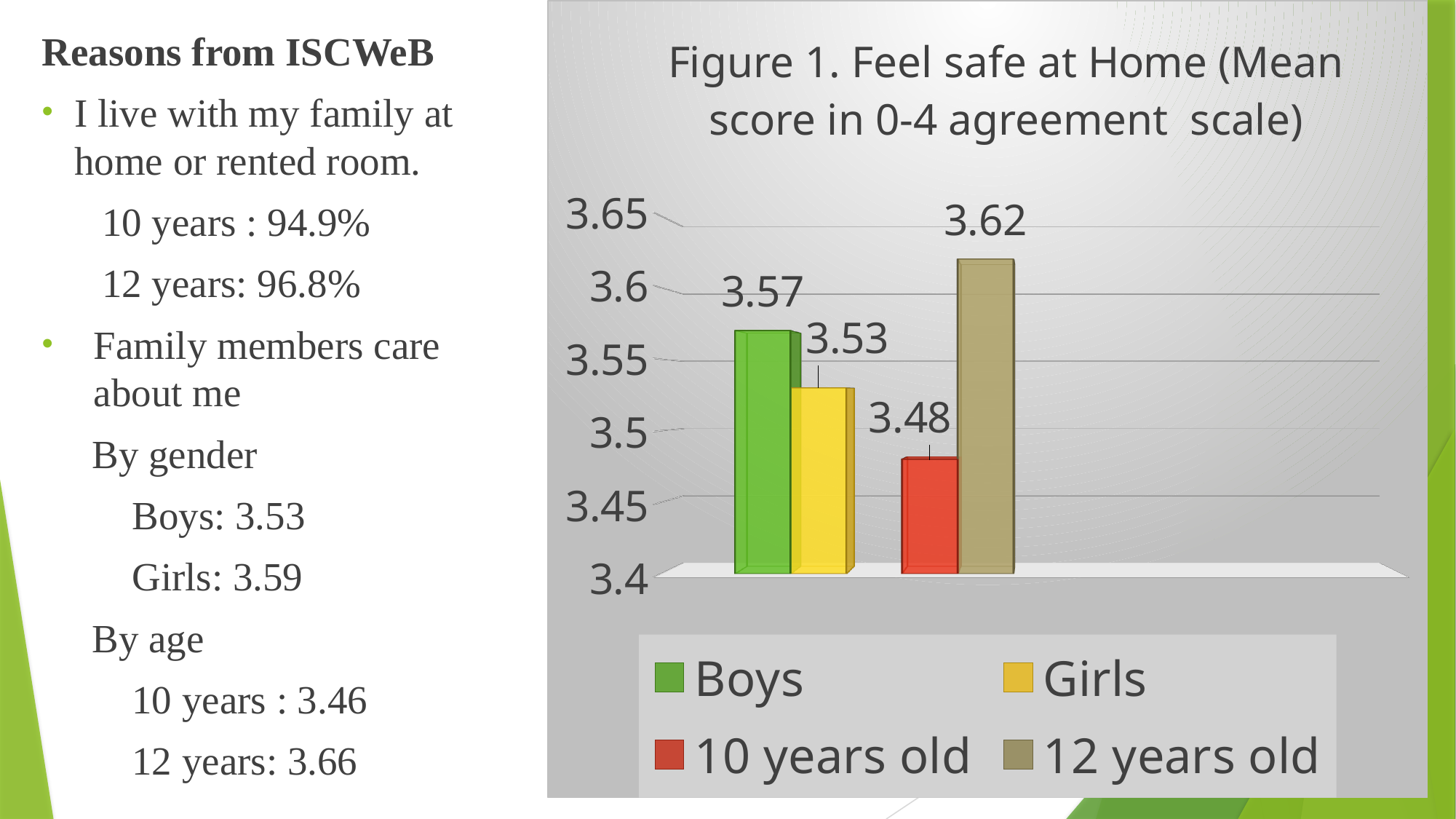
What kind of chart is shown on the slide? bar chart Which group has the highest value in the chart? 12 years old What is the value for 10 years old in the chart? 3.48 How many series does the legend list? 4 Which group has the lowest value in the chart? 10 years old Which is larger, the value for Boys or the value for Girls? Boys What is the title of the chart? Figure 1. Feel safe at Home (Mean score in 0-4 agreement scale) What is the value for Girls in the chart? 3.53 Is the value for 10 years old greater or less than 3.5? less What is the value for 12 years old in the chart? 3.62 What is the difference between the values for 12 years old and 10 years old? 0.14 What is the value for Boys in the chart? 3.57